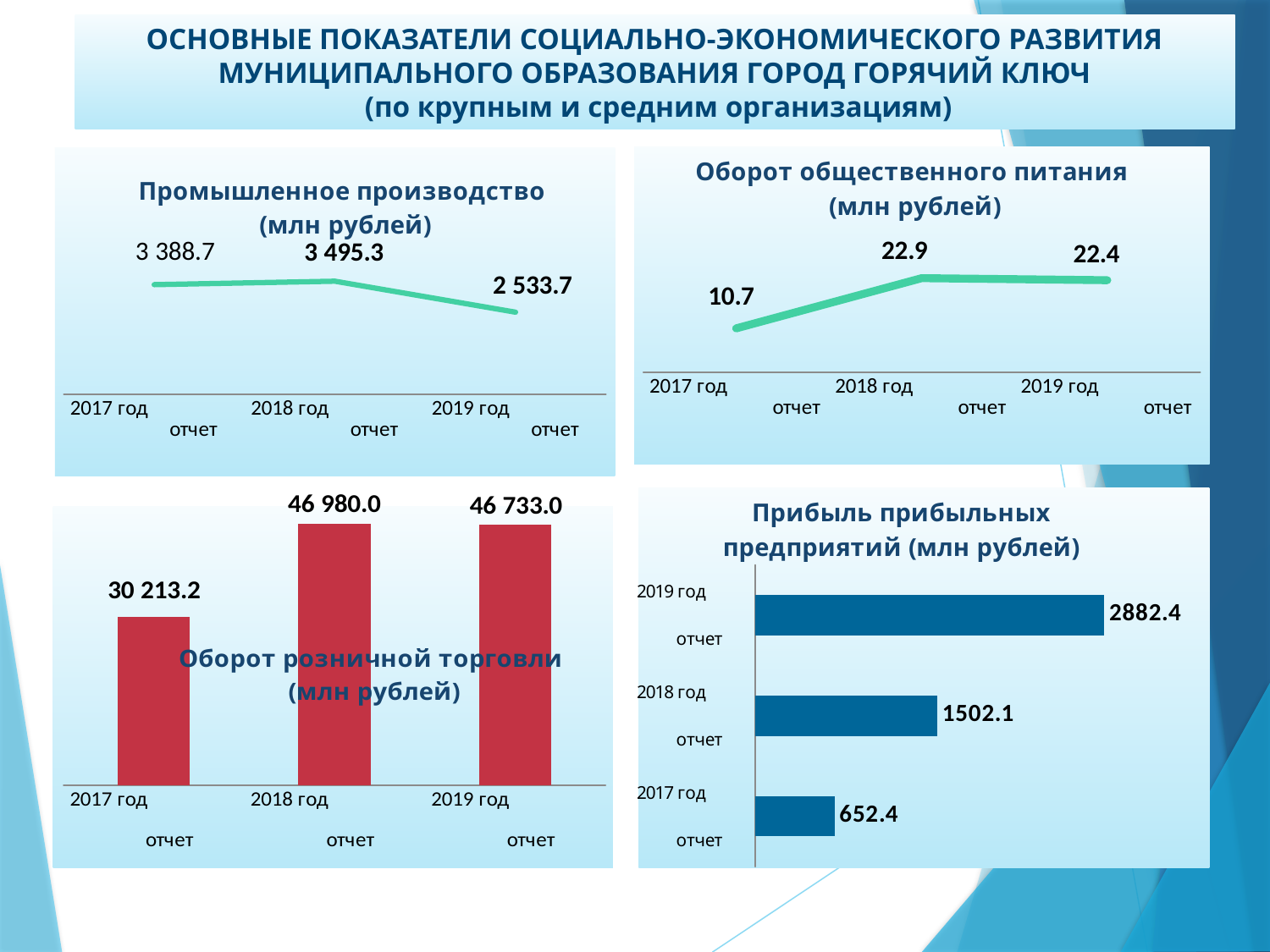
On the chart titled "Промышленное производство (млн рублей)", which year has the lowest value? 2019 год отчет On the chart titled "Промышленное производство (млн рублей)", what is the value for 2018 год отчет? 3 495.3 On the chart titled "Оборот розничной торговли (млн рублей)", what is the value for 2017 год отчет? 30 213.2 On the chart titled "Оборот общественного питания (млн рублей)", what kind of chart is it? line chart On the chart titled "Оборот розничной торговли (млн рублей)", what is the difference between the 2018 and 2019 values? 247.0 On the chart titled "Прибыль прибыльных предприятий (млн рублей)", what is the value for 2018 год отчет? 1502.1 On the chart titled "Промышленное производство (млн рублей)", what is the difference between the 2018 and 2019 values? 961.6 On the chart titled "Оборот розничной торговли (млн рублей)", how many bars are plotted? 3 On the chart titled "Оборот общественного питания (млн рублей)", what is the value for 2017 год отчет? 10.7 On the chart titled "Прибыль прибыльных предприятий (млн рублей)", what is the difference between the 2019 and 2017 values? 2230.0 On the chart titled "Оборот общественного питания (млн рублей)", which year has the highest value? 2018 год отчет On the chart titled "Прибыль прибыльных предприятий (млн рублей)", do the values rise or fall from 2017 to 2019? rise